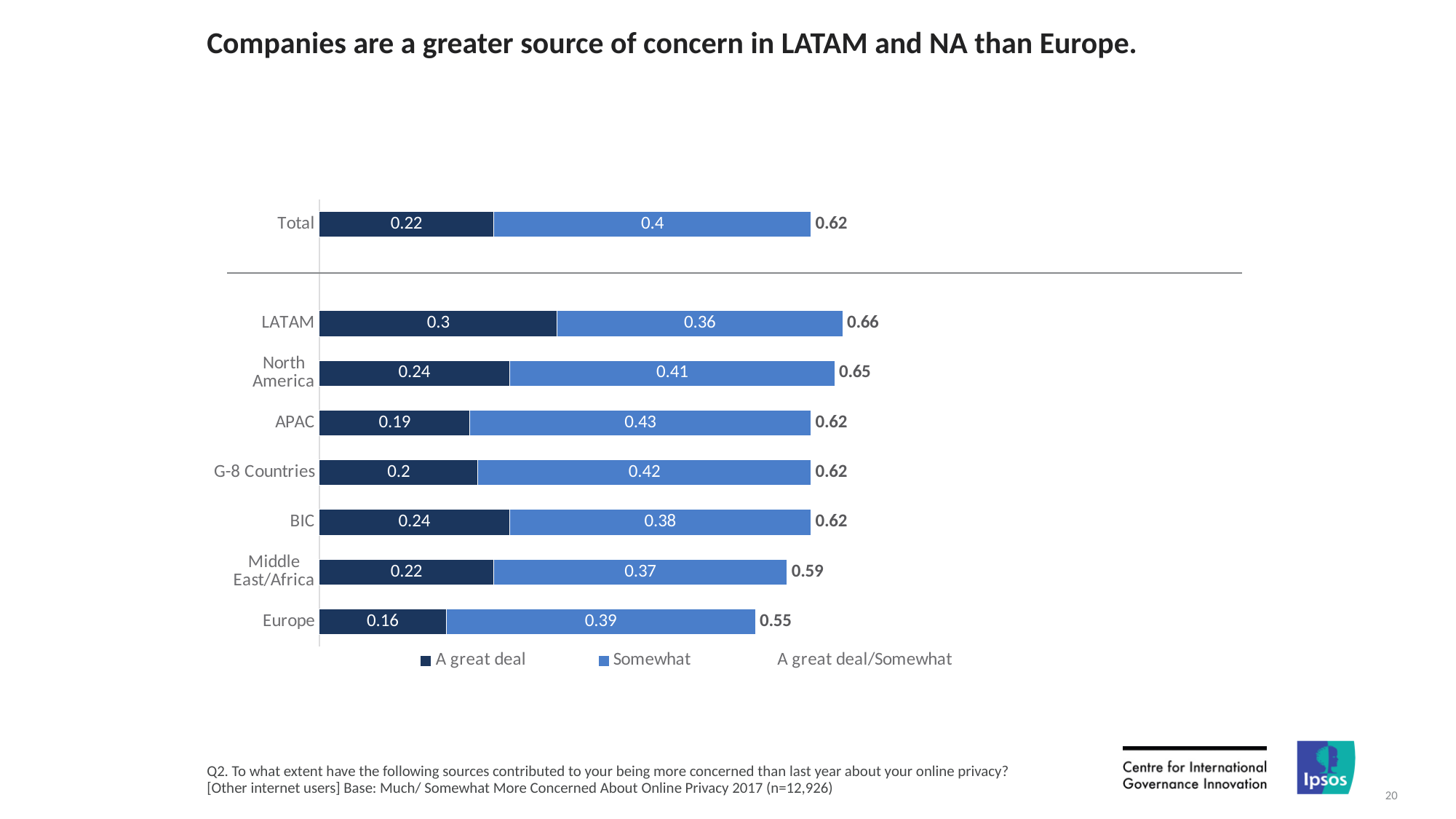
Which is larger, the 'Somewhat' value for North America or for BIC? North America What is the difference between the 'A great deal' values for LATAM and Europe? 0.14 What is the 'A great deal' value for LATAM? 0.3 How many series does the legend list? 3 What is the combined 'A great deal/Somewhat' value for Europe? 0.55 What is the total of the stacked bar for Middle East/Africa? 0.59 What kind of chart is shown on the slide? Stacked bar chart What is the title of the slide? Companies are a greater source of concern in LATAM and NA than Europe. What is the 'Somewhat' value for APAC? 0.43 Which region has the highest 'A great deal' value? LATAM How many regional categories are shown below the Total bar? 7 Which region has the lowest combined 'A great deal/Somewhat' total? Europe